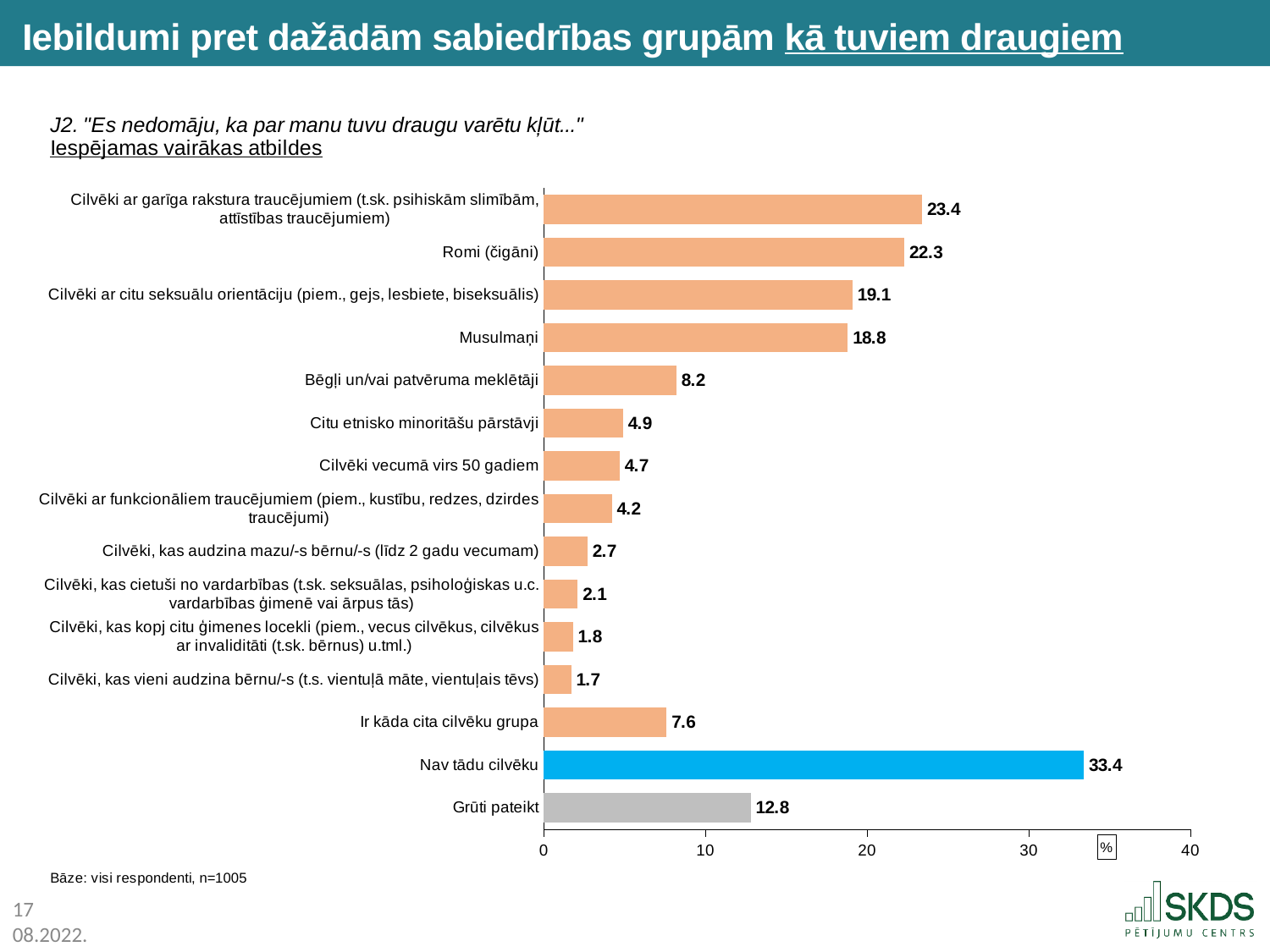
What is the value for Romi (čigāni)? 22.3 How many categories are shown in the chart? 15 Which category has the lowest value? Cilvēki, kas vieni audzina bērnu/-s (t.s. vientuļā māte, vientuļais tēvs) What is the value for Musulmaņi? 18.8 Is the value for Ir kāda cita cilvēku grupa greater or less than 10? less Which is larger, the value for Romi (čigāni) or the value for Musulmaņi? Romi (čigāni) What is the difference between the values for Nav tādu cilvēku and Grūti pateikt? 20.6 What is the difference between the values for Cilvēki ar garīga rakstura traucējumiem and Romi (čigāni)? 1.1 What kind of chart is shown on the slide? bar chart Which category has the highest value? Nav tādu cilvēku What is the value for Grūti pateikt? 12.8 What is the value for Bēgļi un/vai patvēruma meklētāji? 8.2